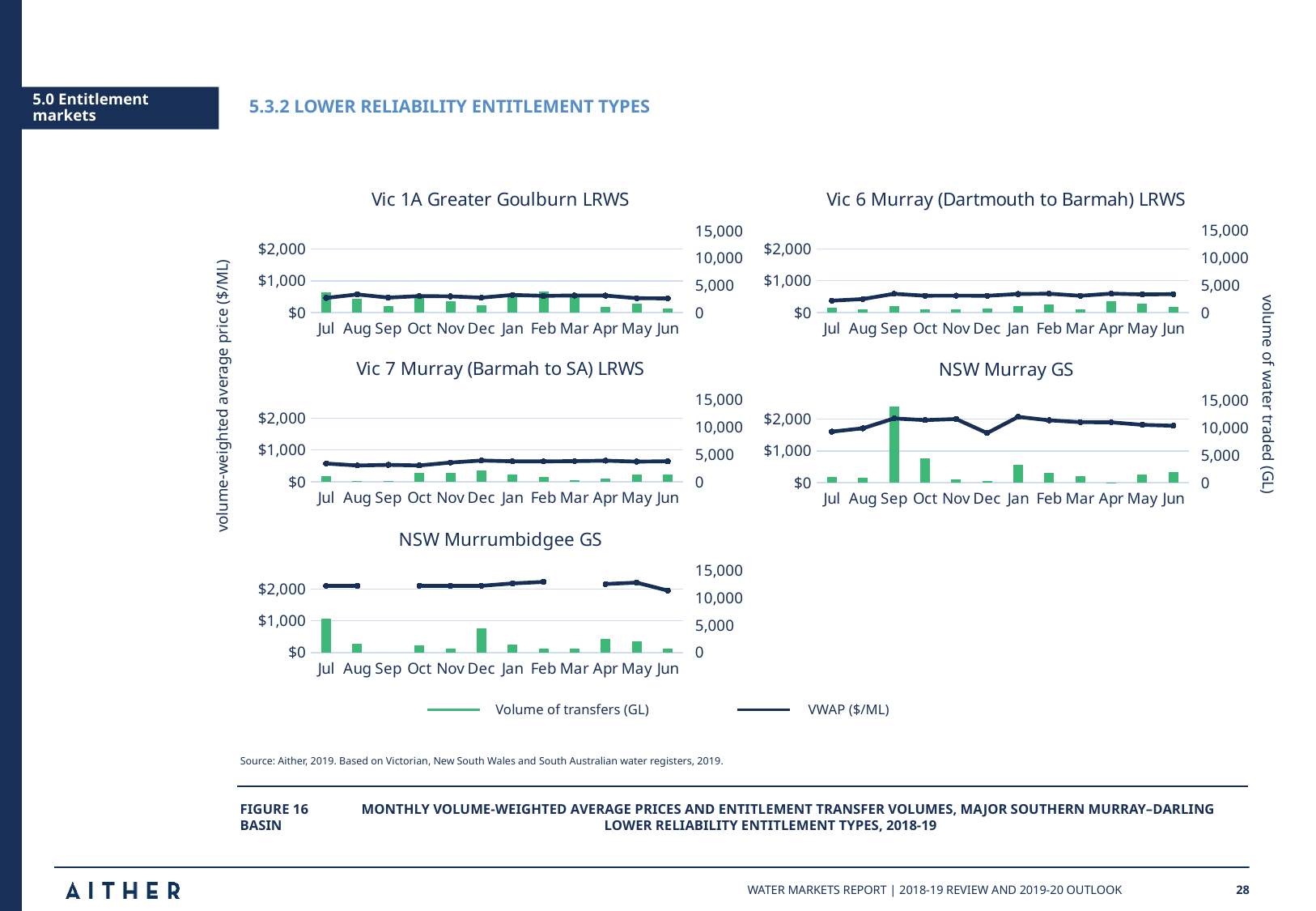
In the Vic 1A Greater Goulburn LRWS chart, is the VWAP in Jul greater or less than $1,000? less In the NSW Murrumbidgee GS chart, which month has the highest volume of transfers? Jul In the NSW Murray GS chart, which month has the highest volume of transfers? Sep What kind of chart is the NSW Murray GS chart? Combined bar and line chart What is the label of the series drawn as a line in the legend? VWAP ($/ML) How many charts are shown on the slide? 5 In the Vic 6 Murray (Dartmouth to Barmah) LRWS chart, which month has the highest volume of transfers? Apr In the NSW Murray GS chart, is the volume of transfers in Sep greater or less than 10,000? greater How many series does the legend list? 2 In the Vic 1A Greater Goulburn LRWS chart, how many months are plotted along the x axis? 12 In the NSW Murrumbidgee GS chart, is the volume of transfers in Jul greater or less than 5,000? greater